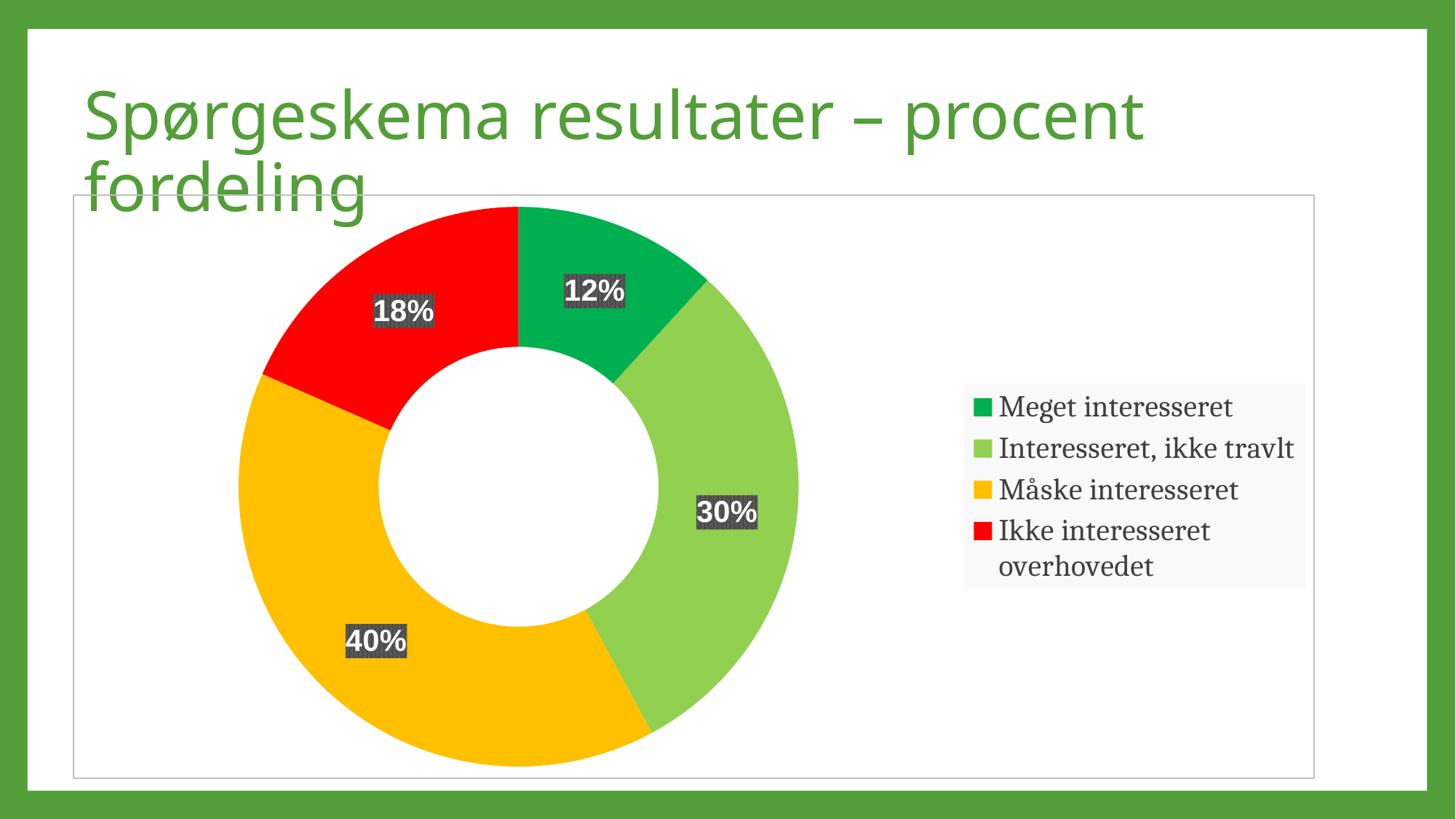
How many categories are shown in the chart? 4 What colour represents 'Ikke interesseret overhovedet' in the chart? Red What percentage of respondents are 'Interesseret, ikke travlt'? 30% Which category has the smallest share of the chart? Meget interesseret What percentage of respondents are 'Ikke interesseret overhovedet'? 18% What kind of chart is shown on the slide? Doughnut (pie) chart What is the difference in percentage points between 'Måske interesseret' and 'Meget interesseret'? 28 What percentage of respondents are 'Måske interesseret'? 40% What is the title of the slide? Spørgeskema resultater – procent fordeling Which category has the largest share of the chart? Måske interesseret Which is larger: the share for 'Interesseret, ikke travlt' or the share for 'Ikke interesseret overhovedet'? Interesseret, ikke travlt What percentage of respondents are 'Meget interesseret'? 12%